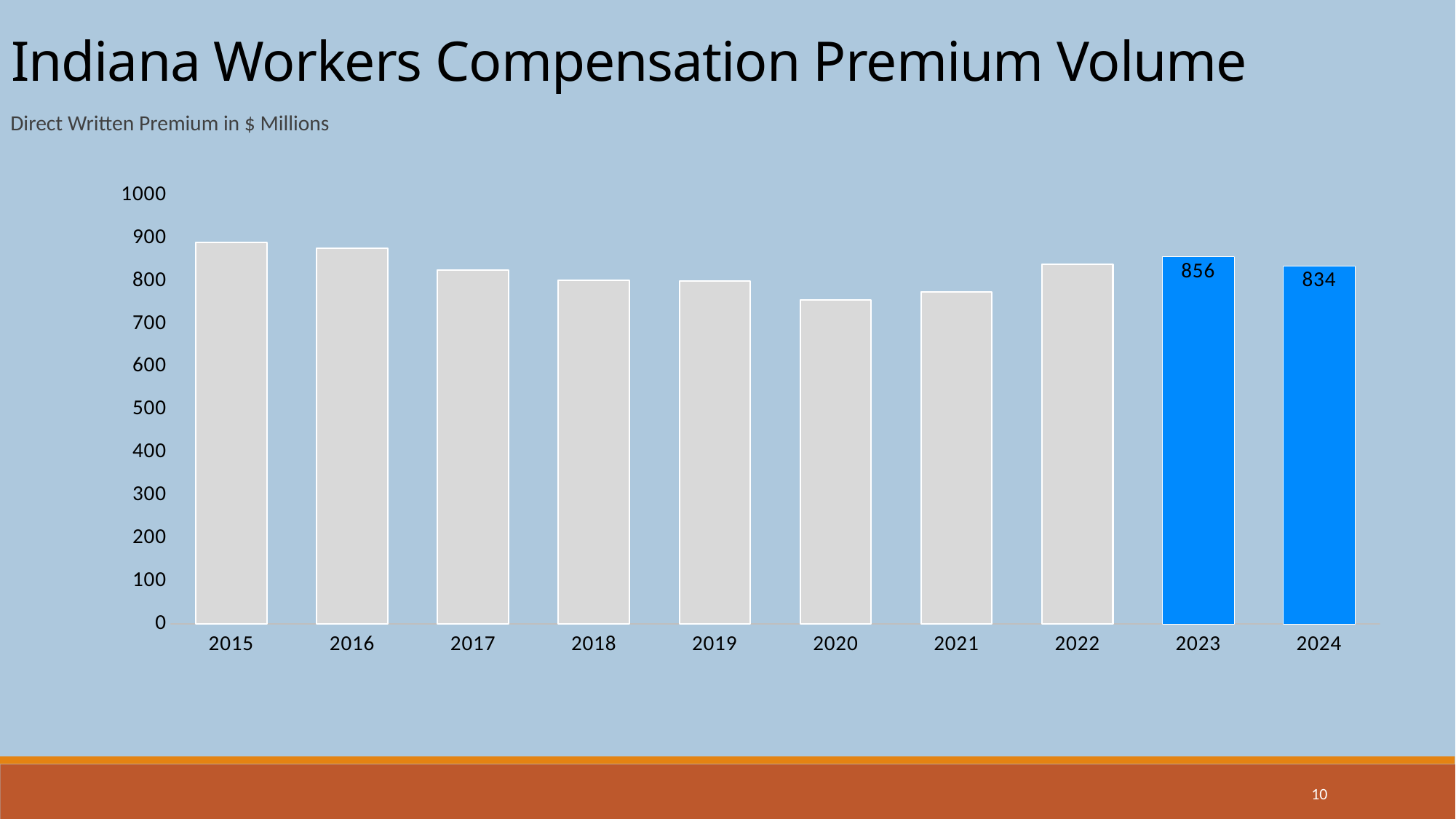
Do the values rise or fall from 2015 to 2020? fall Is the value for 2021 greater or less than 800? less Which is larger, the value for 2015 or the value for 2020? 2015 Is the value for 2020 greater or less than 800? less Which year has the lowest value? 2020 Which is larger, the value for 2023 or the value for 2024? 2023 What is the difference between the values for 2023 and 2024? 22 What is the value for 2023? 856 Is the value for 2015 greater or less than 800? greater How many years are shown on the chart? 10 What is the value for 2024? 834 What kind of chart is shown on the slide? bar chart